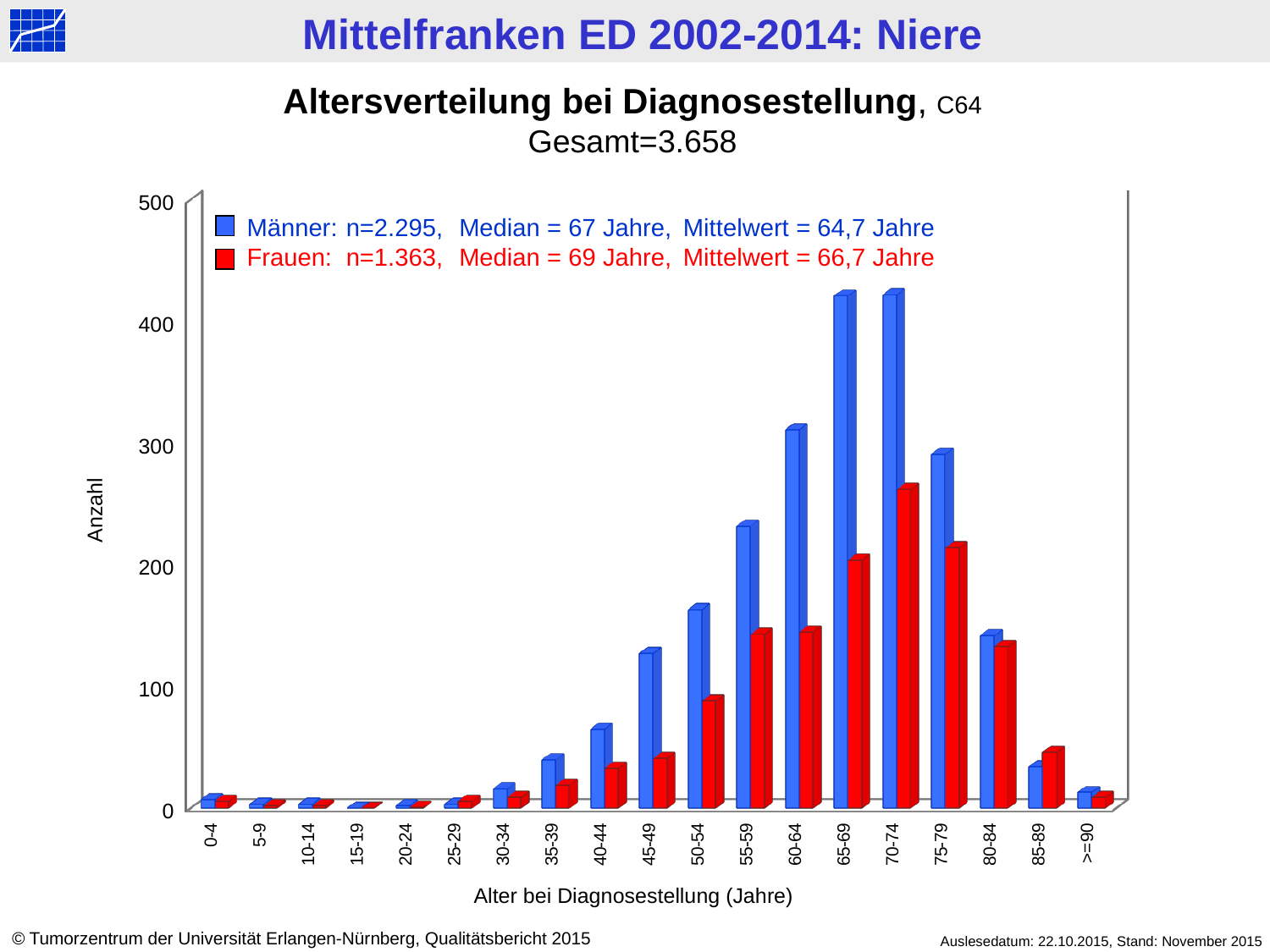
According to the legend, what is the median age at diagnosis for Frauen? 69 Jahre Is the value for Frauen in the 50-54 age group greater or less than 100? less Which age group has the highest value for Frauen? 70-74 In the 55-59 age group, which series has the larger value, Männer or Frauen? Männer How many series does the legend list? 2 How many age-group categories are shown on the x axis? 19 Is the value for Frauen in the 70-74 age group greater or less than 200? greater Is the value for Frauen in the 85-89 age group greater or less than 100? less What kind of chart is shown on the slide? bar chart In the 85-89 age group, which series has the larger value, Männer or Frauen? Frauen